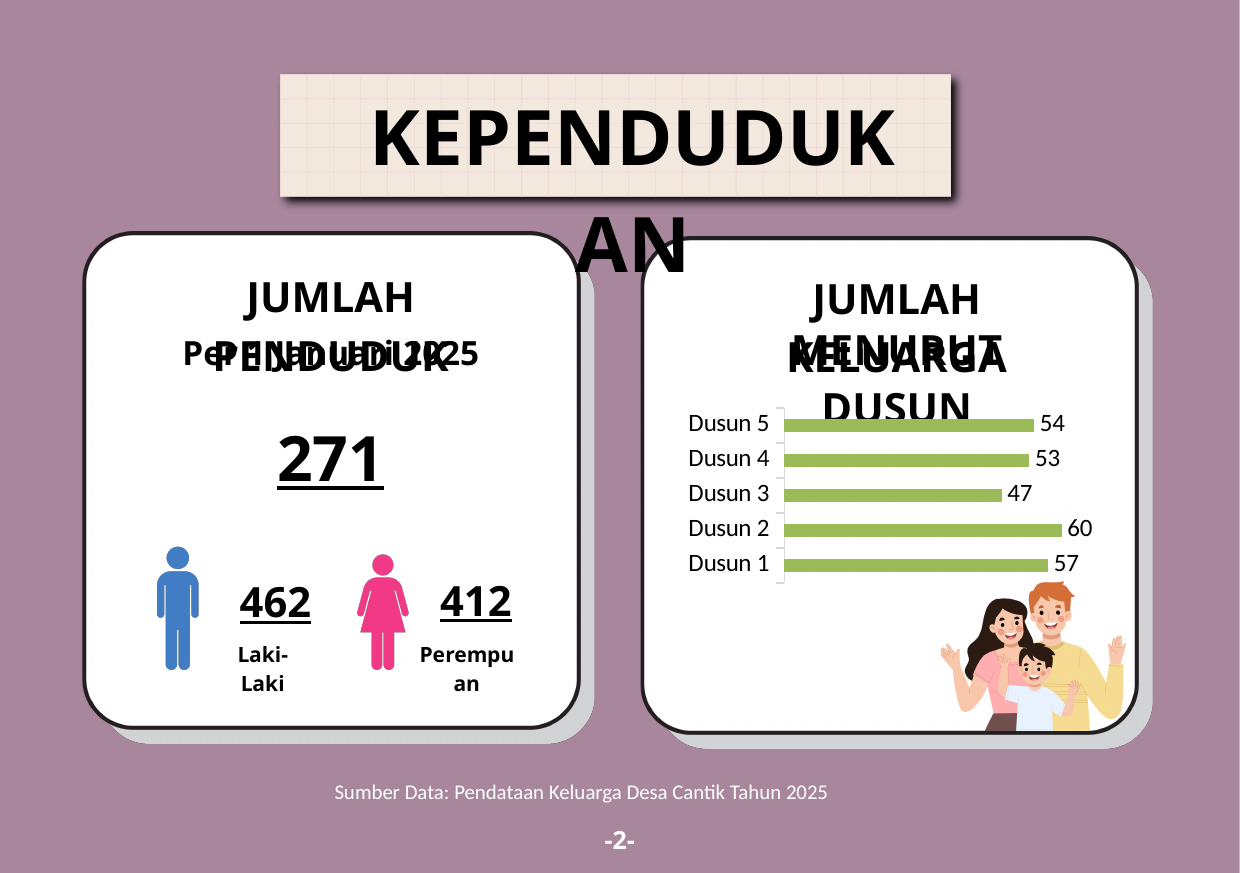
What is the difference between the values for Dusun 1 and Dusun 4 in the bar chart? 4 What kind of chart is used to show the values per dusun? Bar chart Which dusun has the lowest value in the bar chart? Dusun 3 What is the value for Dusun 5 in the bar chart? 54 What colour are the bars in the dusun chart? Green What is the difference between the values for Dusun 2 and Dusun 3 in the bar chart? 13 Which has a larger value in the bar chart, Dusun 4 or Dusun 5? Dusun 5 What is the value for Dusun 3 in the bar chart? 47 What is the value for Dusun 2 in the bar chart? 60 What is the value for Dusun 1 in the bar chart? 57 How many dusun categories are shown in the bar chart? 5 Which dusun has the highest value in the bar chart? Dusun 2